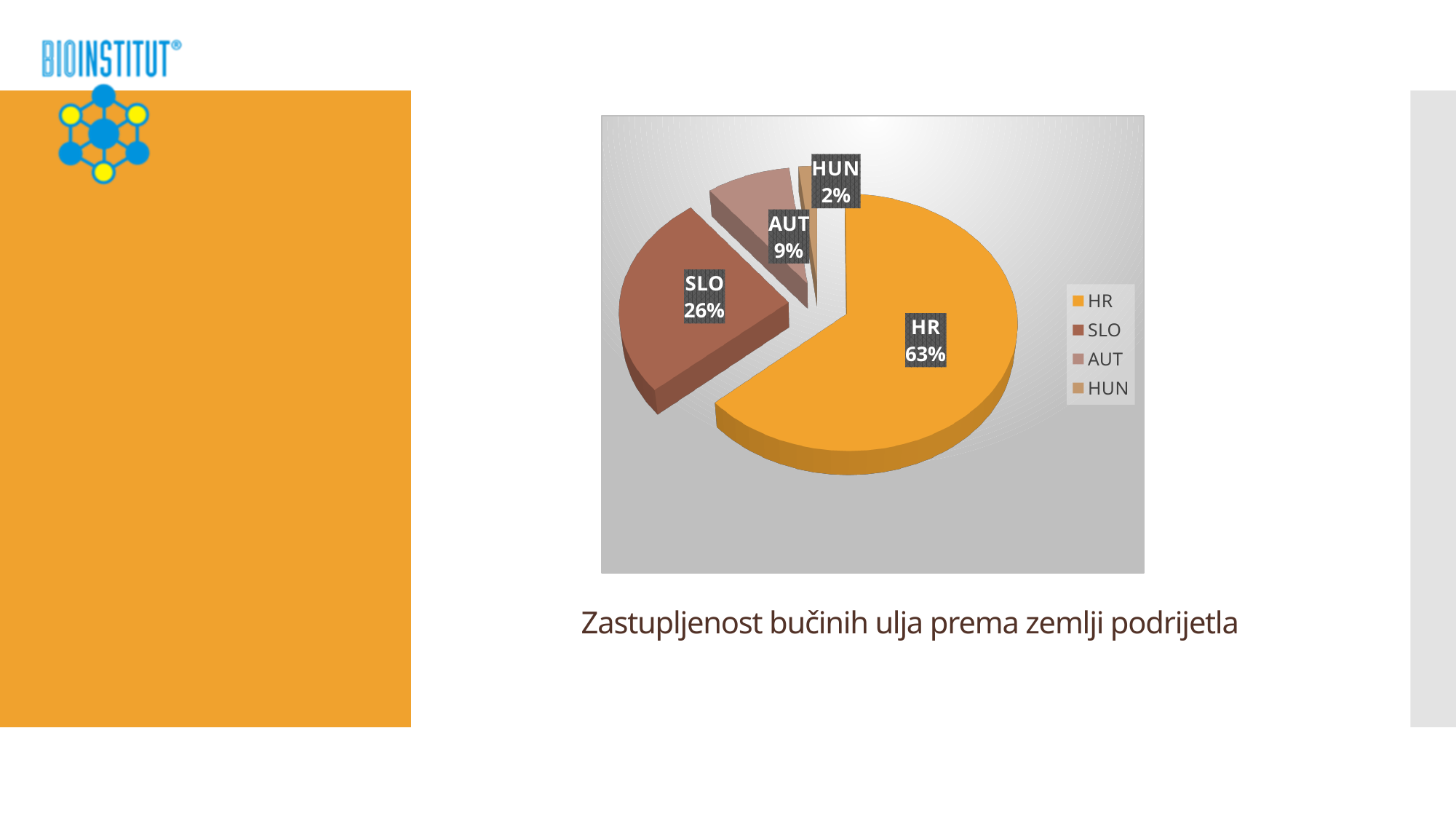
Which country has the smallest slice of the pie? HUN What share of the pie does SLO have? 26% What is the difference in percentage points between AUT and HUN? 7 Which country has the largest slice of the pie? HR What kind of chart is shown on the slide? Pie chart What share of the pie does HR have? 63% What share of the pie does AUT have? 9% What is the caption below the chart? Zastupljenost bučinih ulja prema zemlji podrijetla What share of the pie does HUN have? 2% How many slices does the pie chart have? 4 What is the difference in percentage points between HR and SLO? 37 Which is larger, the share for SLO or the share for AUT? SLO